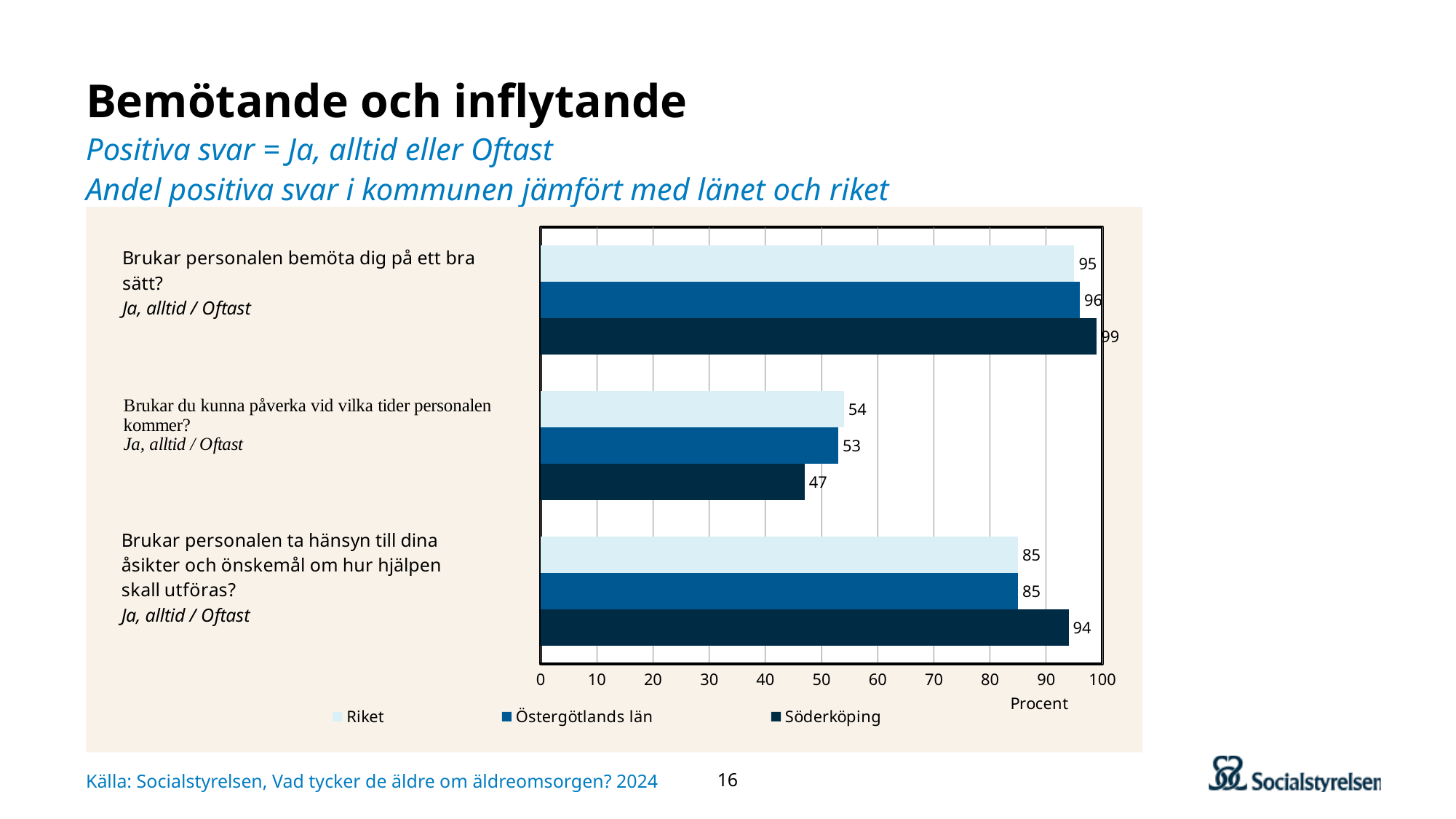
Which series has the lowest value on the question "Brukar du kunna påverka vid vilka tider personalen kommer?"? Söderköping What is the difference between Söderköping and Riket on the question "Brukar personalen ta hänsyn till dina åsikter och önskemål om hur hjälpen skall utföras?"? 9 What is the label of the horizontal axis? Procent What is the value for Riket on the question "Brukar du kunna påverka vid vilka tider personalen kommer?"? 54 Which is larger on the question "Brukar du kunna påverka vid vilka tider personalen kommer?": Riket or Söderköping? Riket How many questions (categories) are shown in the chart? 3 What kind of chart is shown on the slide? Bar chart What is the value for Söderköping on the question "Brukar personalen bemöta dig på ett bra sätt?"? 99 Which series is shown in the darkest blue colour? Söderköping How many series does the legend list? 3 Which series has the highest value on the question "Brukar personalen ta hänsyn till dina åsikter och önskemål om hur hjälpen skall utföras?"? Söderköping What is the value for Östergötlands län on the question "Brukar personalen ta hänsyn till dina åsikter och önskemål om hur hjälpen skall utföras?"? 85